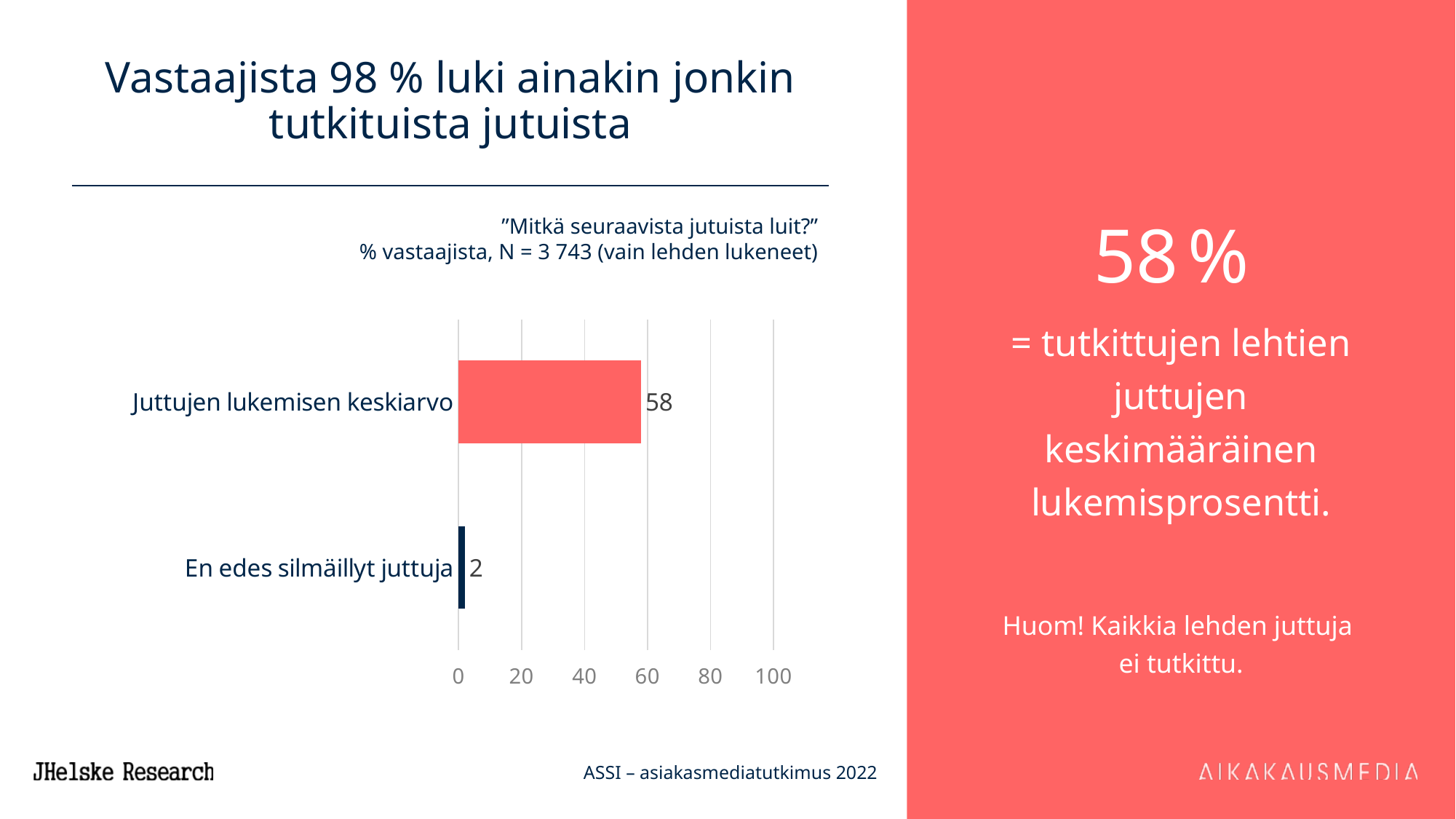
What is the value for "En edes silmäillyt juttuja"? 2 How many categories are shown in the chart? 2 What is the difference between the values for "Juttujen lukemisen keskiarvo" and "En edes silmäillyt juttuja"? 56 Is the value for "Juttujen lukemisen keskiarvo" greater or less than 40? greater Which category has the highest value? Juttujen lukemisen keskiarvo Is the value for "En edes silmäillyt juttuja" greater or less than 20? less What kind of chart is shown on the slide? Bar chart Which category has the lowest value? En edes silmäillyt juttuja Which is larger, the value for "Juttujen lukemisen keskiarvo" or for "En edes silmäillyt juttuja"? Juttujen lukemisen keskiarvo What is the value for "Juttujen lukemisen keskiarvo"? 58 What is the highest value shown on the chart's axis? 100 What is the sample size (N) stated in the chart subtitle? 3 743